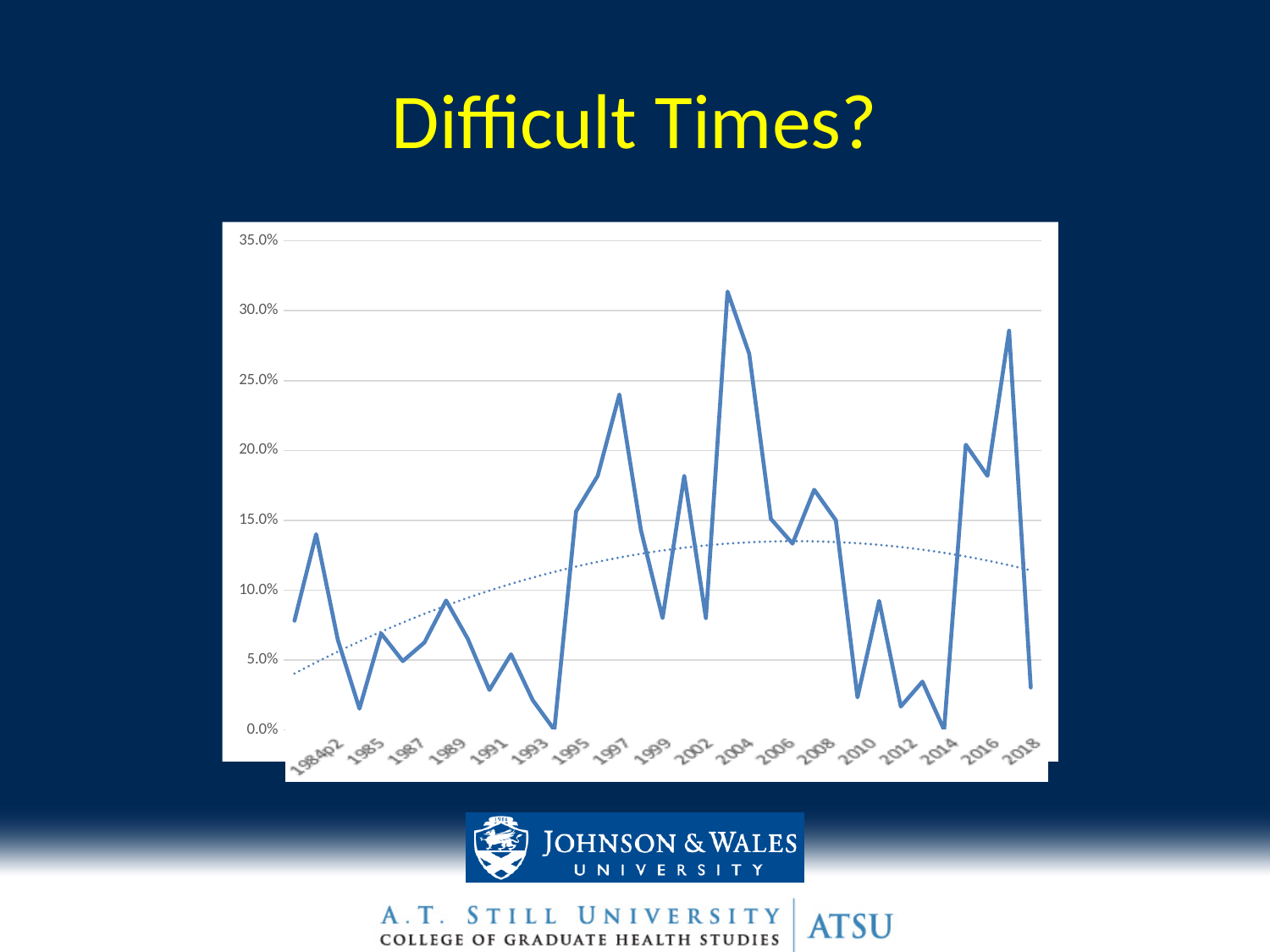
How many year labels are shown along the x axis of the chart? 18 What is the title of the slide containing the chart? Difficult Times? What is the highest value shown on the chart's vertical axis? 35.0% What kind of chart is shown on the slide? line chart Is the value for 2004 greater or less than 25%? greater Is the highest point on the solid line greater or less than 30%? greater Which has the larger value, 2016 or 2018? 2016 Is the value for 2018 greater or less than 5%? less Which has the larger value, 1997 or 1985? 1997